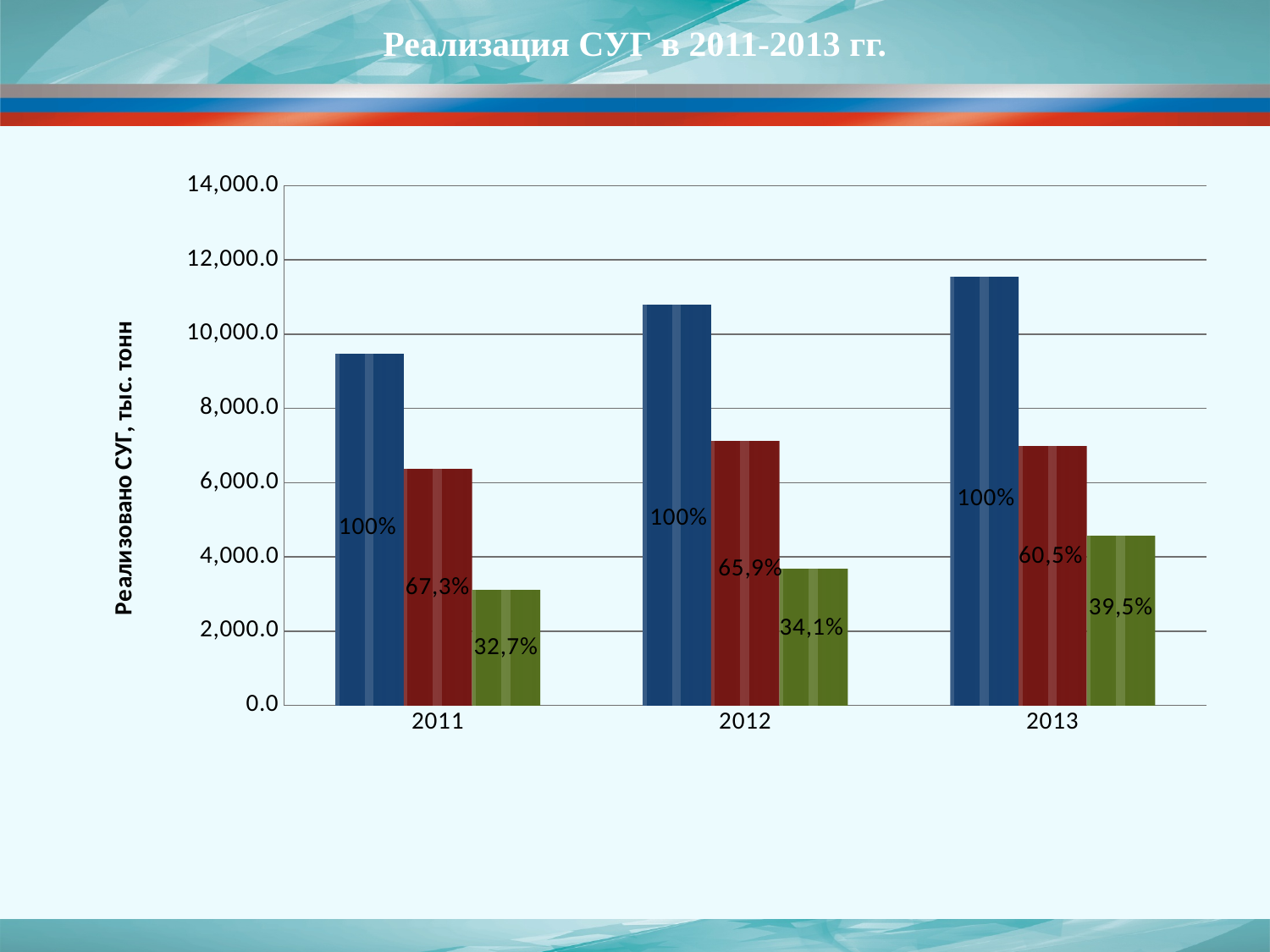
What is the label of the vertical axis? Реализовано СУГ, тыс. тонн What percentage label is shown on the green bar for 2013? 39,5% Is the value of the blue bar for 2011 greater or less than 8,000.0? greater Do the blue bars rise or fall from 2011 to 2013? rise What percentage label is shown on the red bar for 2011? 67,3% What percentage label is shown on the red bar for 2013? 60,5% Is the value of the green bar for 2011 greater or less than 4,000.0? less What percentage label is shown on the green bar for 2012? 34,1% What is the title of the chart? Реализация СУГ в 2011-2013 гг. What kind of chart is shown on the slide? bar chart In which year is the blue bar the tallest? 2013 How many years are shown on the x axis? 3